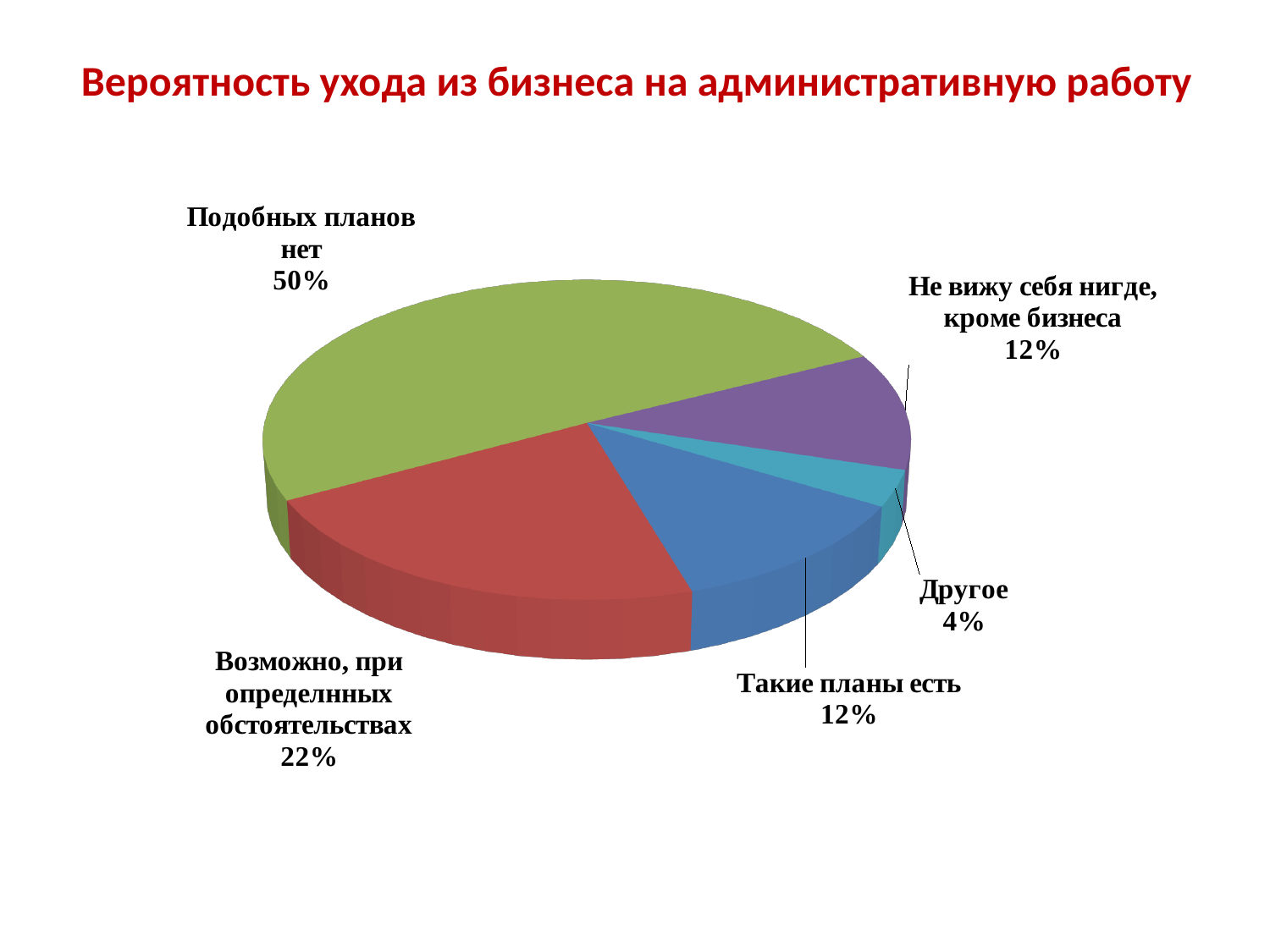
What percentage is shown for "Другое"? 4% Which category has the largest share of the pie? Подобных планов нет What share of the pie is labelled "Подобных планов нет"? 50% What percentage is shown for "Возможно, при определнных обстоятельствах"? 22% Which is larger: the share for "Возможно, при определнных обстоятельствах" or the share for "Такие планы есть"? Возможно, при определнных обстоятельствах What is the title of the slide? Вероятность ухода из бизнеса на административную работу Which category has the smallest share of the pie? Другое What type of chart is shown on the slide? Pie chart How many slices does the pie chart have? 5 What percentage is shown for "Не вижу себя нигде, кроме бизнеса"? 12% What percentage is shown for "Такие планы есть"? 12% What is the difference in percentage points between "Подобных планов нет" and "Возможно, при определнных обстоятельствах"? 28%